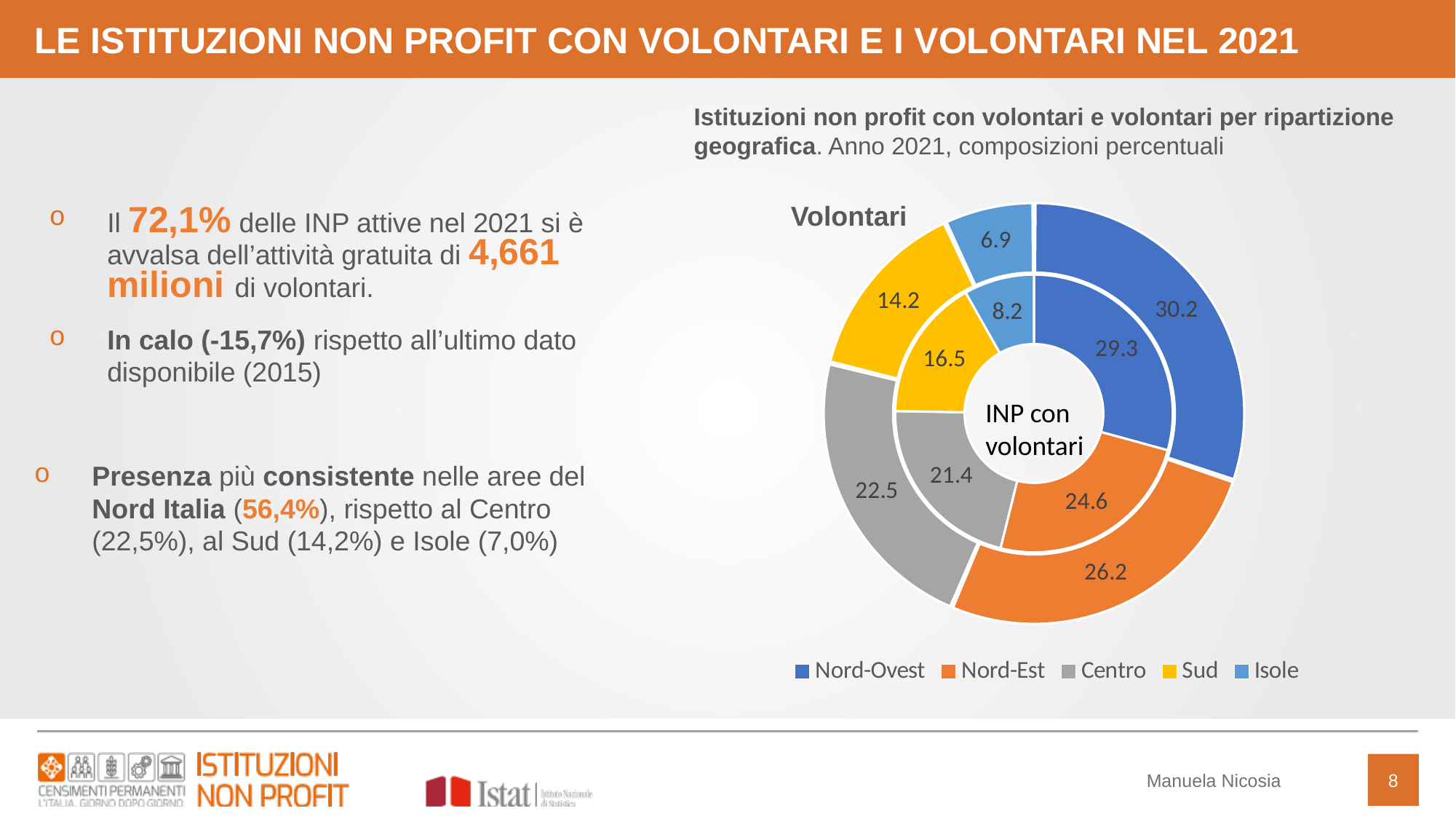
In the inner ring (INP con volontari), what is the value for Centro? 21.4 Which category has the smallest share in the inner ring (INP con volontari)? Isole How many categories does the legend of the doughnut chart list? 5 In the outer ring (Volontari), what is the value for Nord-Ovest? 30.2 What is the difference between the Nord-Ovest and Nord-Est values in the outer ring (Volontari)? 4.0 Which category has the largest share in the outer ring (Volontari)? Nord-Ovest What is the difference between the Sud values in the inner ring (16.5) and the outer ring (14.2)? 2.3 Which colour represents Centro in the doughnut chart? Grey What kind of chart is shown on the slide? Doughnut chart In the inner ring (INP con volontari), which is larger: Nord-Est or Centro? Nord-Est In the outer ring (Volontari), what is the value for Isole? 6.9 In the inner ring (INP con volontari), what is the value for Sud? 16.5